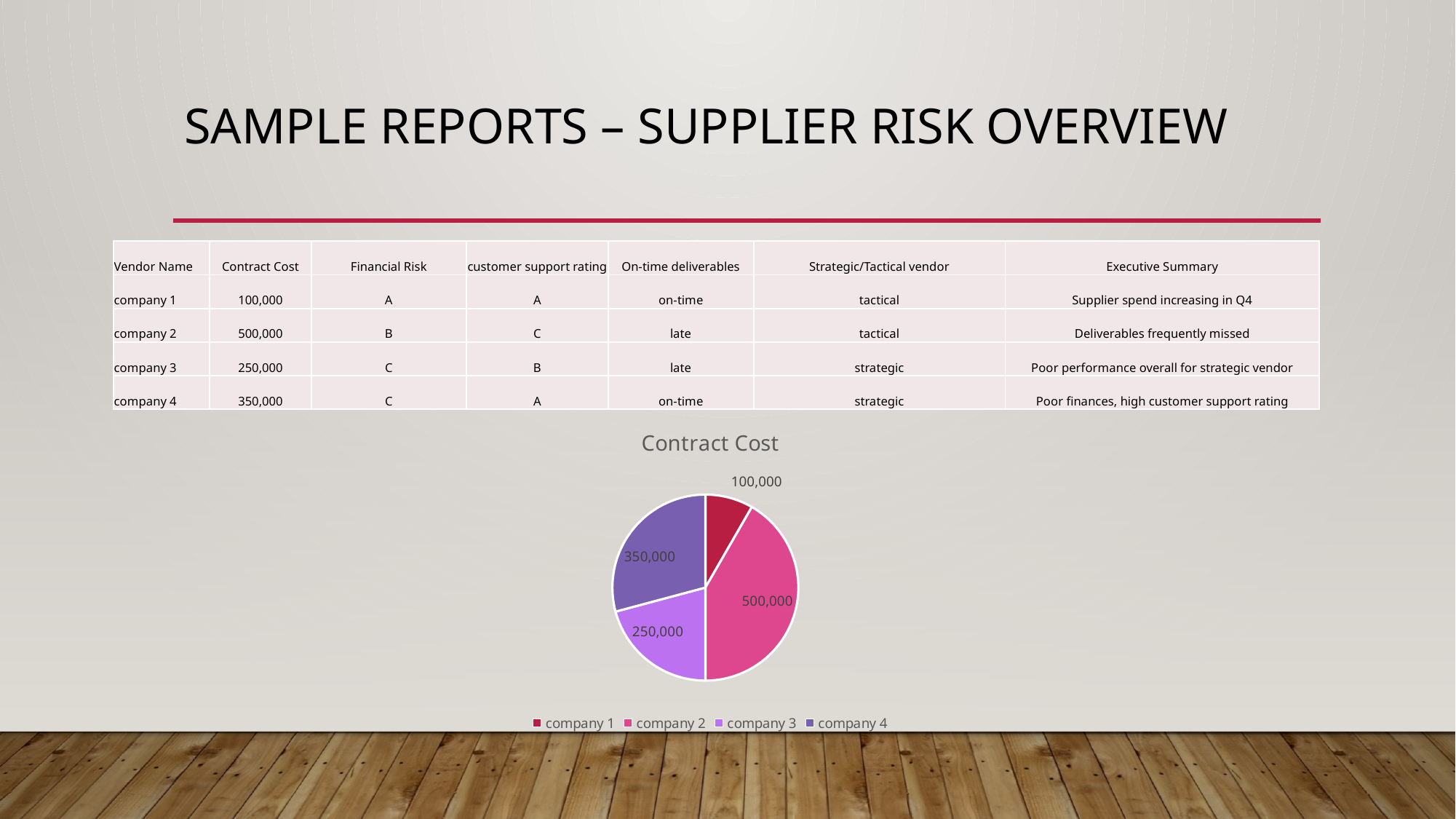
What kind of chart is shown on the slide? pie chart What is the total contract cost across all four slices of the pie chart? 1,200,000 Which has a larger contract cost, company 3 or company 4? company 4 Which company has the largest slice of the pie chart? company 2 Which company has the smallest slice of the pie chart? company 1 What is the contract cost for company 4 in the pie chart? 350,000 What is the contract cost for company 2 in the pie chart? 500,000 What is the title of the chart? Contract Cost How many entries does the chart legend list? 4 What is the contract cost for company 1 in the pie chart? 100,000 How many slices does the pie chart have? 4 What is the difference between the contract cost of company 2 and company 3? 250,000